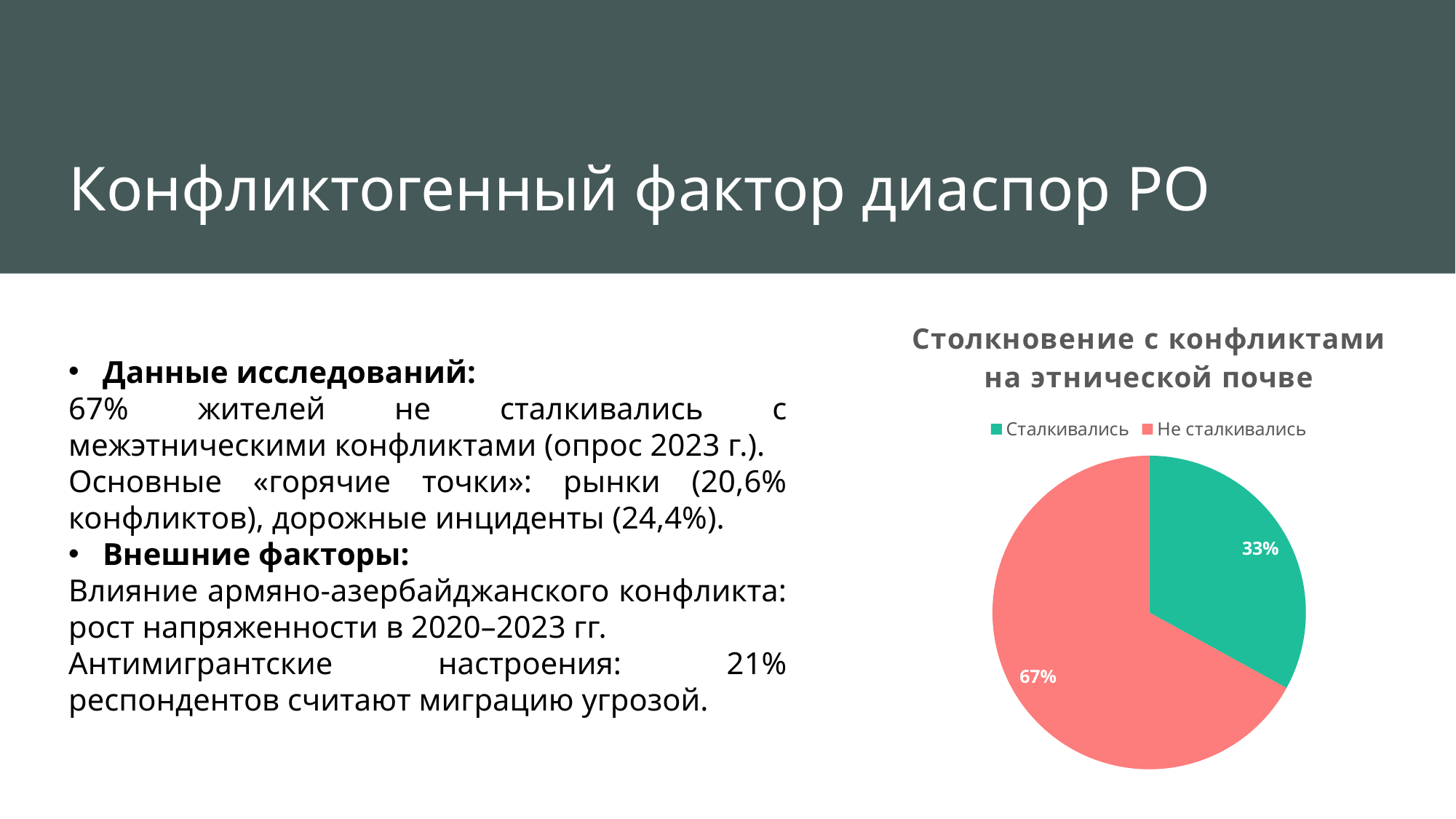
What colour is the "Сталкивались" slice? Green What share of the pie is labelled "Не сталкивались"? 67% How many entries does the chart legend list? 2 What share of the pie is labelled "Сталкивались"? 33% What is the title of the chart? Столкновение с конфликтами на этнической почве What is the difference in percentage points between the "Не сталкивались" and "Сталкивались" slices? 34 Which slice of the pie is the smallest? Сталкивались How many slices does the pie chart have? 2 Which slice of the pie is the largest? Не сталкивались Which is larger: the "Сталкивались" slice or the "Не сталкивались" slice? Не сталкивались What kind of chart is shown on the slide? Pie chart